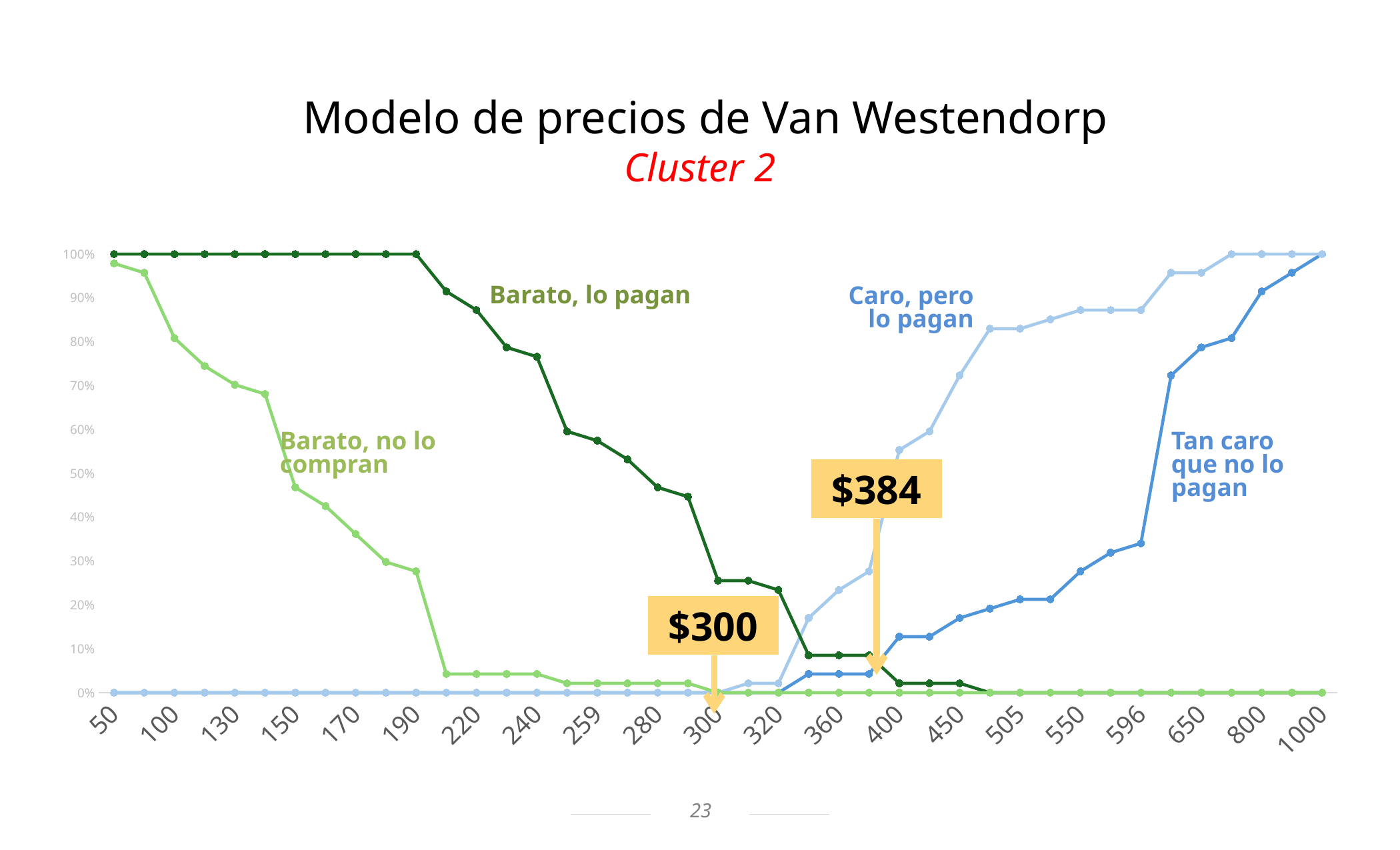
Is the value of 'Barato, no lo compran' at the price of 130 greater or less than 60%? greater Does the 'Caro, pero lo pagan' series rise or fall as the price increases along the x axis? rise Does the 'Barato, lo pagan' series rise or fall as the price increases along the x axis? fall What is the value of the 'Tan caro que no lo pagan' series at the price of 1000? 100% What is the value of the 'Tan caro que no lo pagan' series at the price of 50? 0% At the price of 400, which series has the higher value: 'Caro, pero lo pagan' or 'Tan caro que no lo pagan'? Caro, pero lo pagan What is the value of the 'Barato, lo pagan' series at the price of 50? 100% Which two price points are highlighted with yellow callout boxes on the chart? $300 and $384 Is the value of 'Caro, pero lo pagan' at the price of 450 greater or less than 60%? greater What is the value of the 'Barato, no lo compran' series at the price of 1000? 0% What kind of chart is shown on the slide? line chart How many data series are plotted on the chart? 4